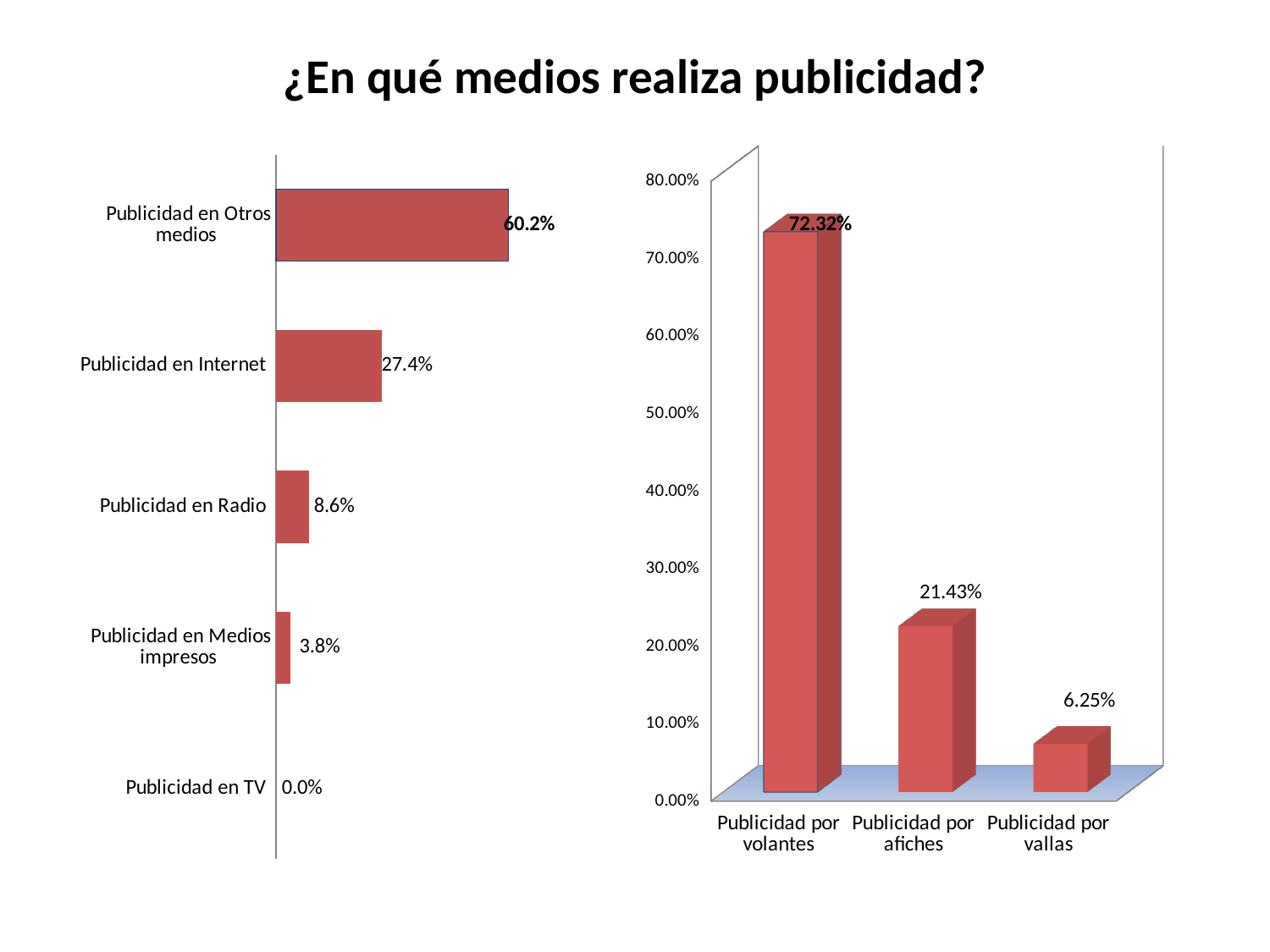
In the left chart, which is larger, Publicidad en Radio or Publicidad en Medios impresos? Publicidad en Radio In the left chart, what is the value for Publicidad en Otros medios? 60.2% In the left chart, what is the difference between Publicidad en Internet and Publicidad en Radio? 18.8% In the left chart, how many categories are shown? 5 In the right chart, which category has the highest value? Publicidad por volantes In the right chart, what is the value for Publicidad por afiches? 21.43% In the right chart, what is the difference between Publicidad por volantes and Publicidad por vallas? 66.07% In the left chart, what is the value for Publicidad en TV? 0.0% What kind of chart is the right chart? Bar chart In the right chart, how many categories are shown? 3 In the left chart, which category has the lowest value? Publicidad en TV In the left chart, what is the value for Publicidad en Internet? 27.4%